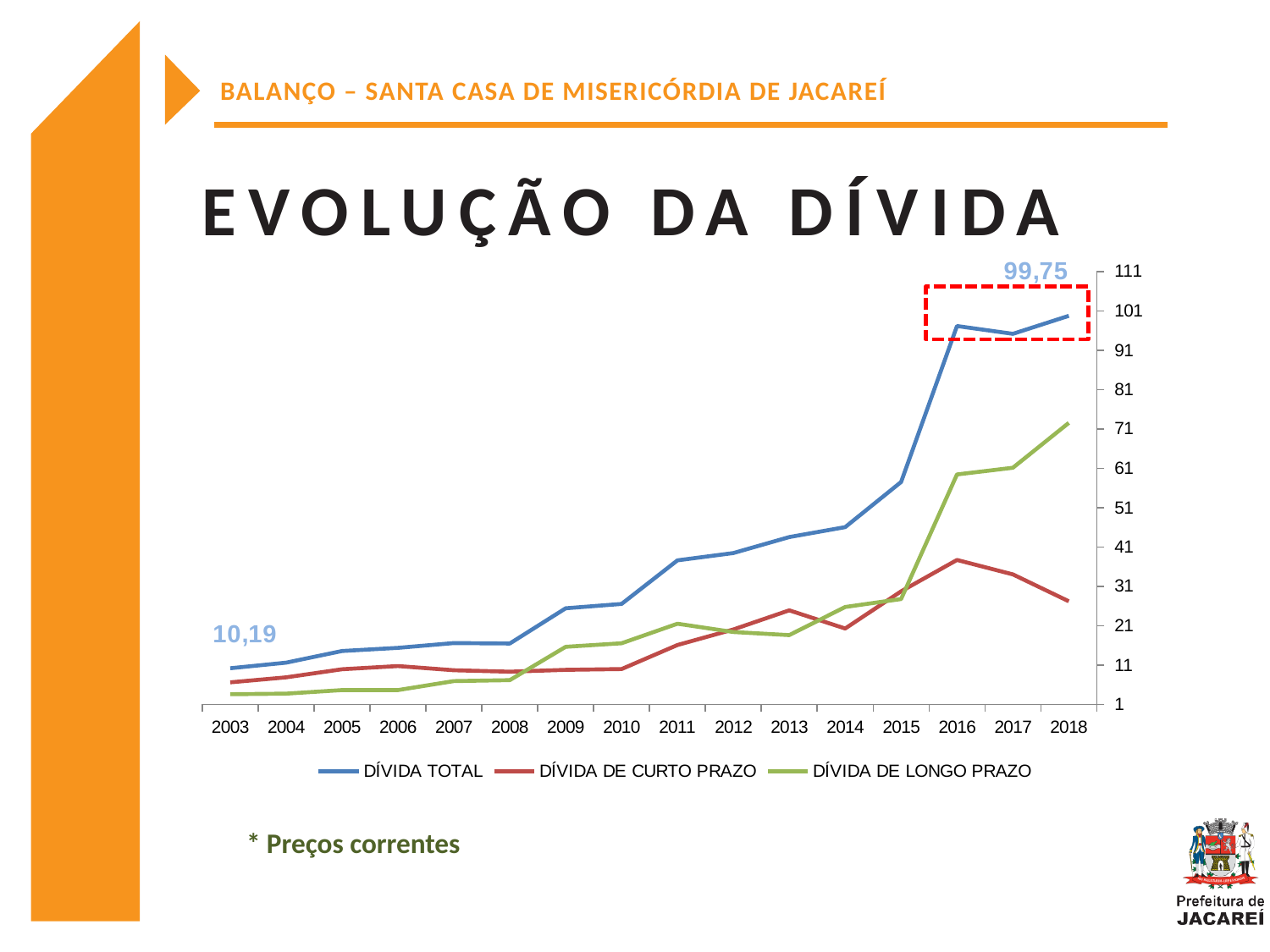
Is the value for DÍVIDA DE CURTO PRAZO in 2018 greater or less than 41? less What colour is the DÍVIDA TOTAL line? Blue How many series does the legend list? 3 How many years are plotted on the x axis? 16 Does DÍVIDA TOTAL rise or fall from 2003 to 2018? Rise What is the value of DÍVIDA TOTAL in 2018? 99,75 What kind of chart is shown on the slide? Line chart Is the value for DÍVIDA DE LONGO PRAZO in 2018 greater or less than 61? greater In 2016, which is larger: DÍVIDA DE CURTO PRAZO or DÍVIDA DE LONGO PRAZO? DÍVIDA DE LONGO PRAZO In which year is DÍVIDA TOTAL lowest? 2003 What is the value of DÍVIDA TOTAL in 2003? 10,19 What is the difference between the DÍVIDA TOTAL values in 2018 and 2003? 89,56